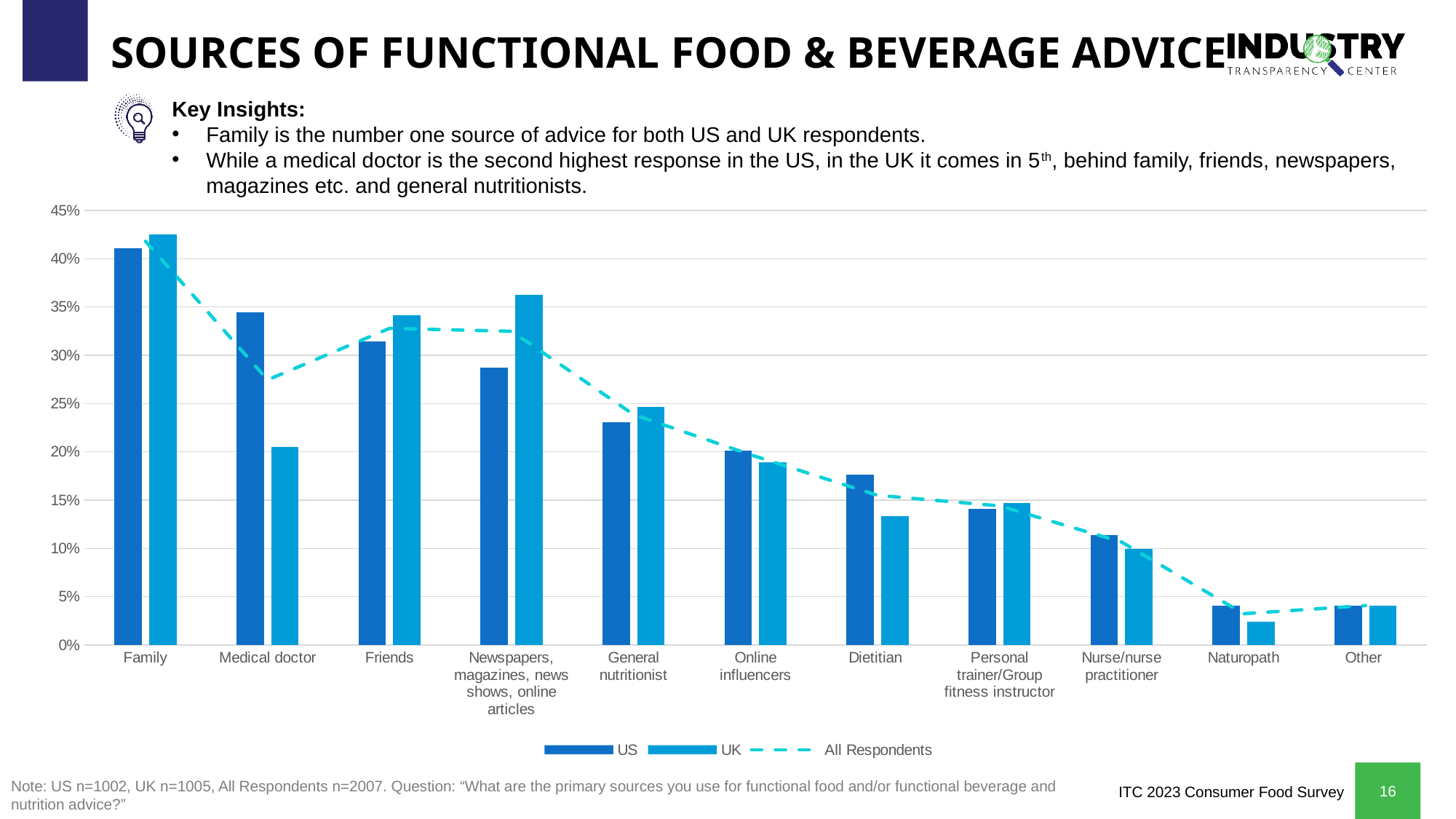
Is the UK value for Medical doctor greater or less than 25%? less Which category has the lowest value for the UK series? Naturopath Which series is plotted as a dashed line rather than bars? All Respondents For Newspapers, magazines, news shows, online articles, which is larger, the US value or the UK value? UK What kind of chart is shown on the slide? combination bar and line chart Is the UK value for Dietitian greater or less than 15%? less Which category has the highest value for the UK series? Family Is the US value for Friends greater or less than 30%? greater Which category has the highest value for the US series? Family For Medical doctor, which is larger, the US value or the UK value? US How many source categories are shown along the x axis? 11 How many series does the legend list? 3